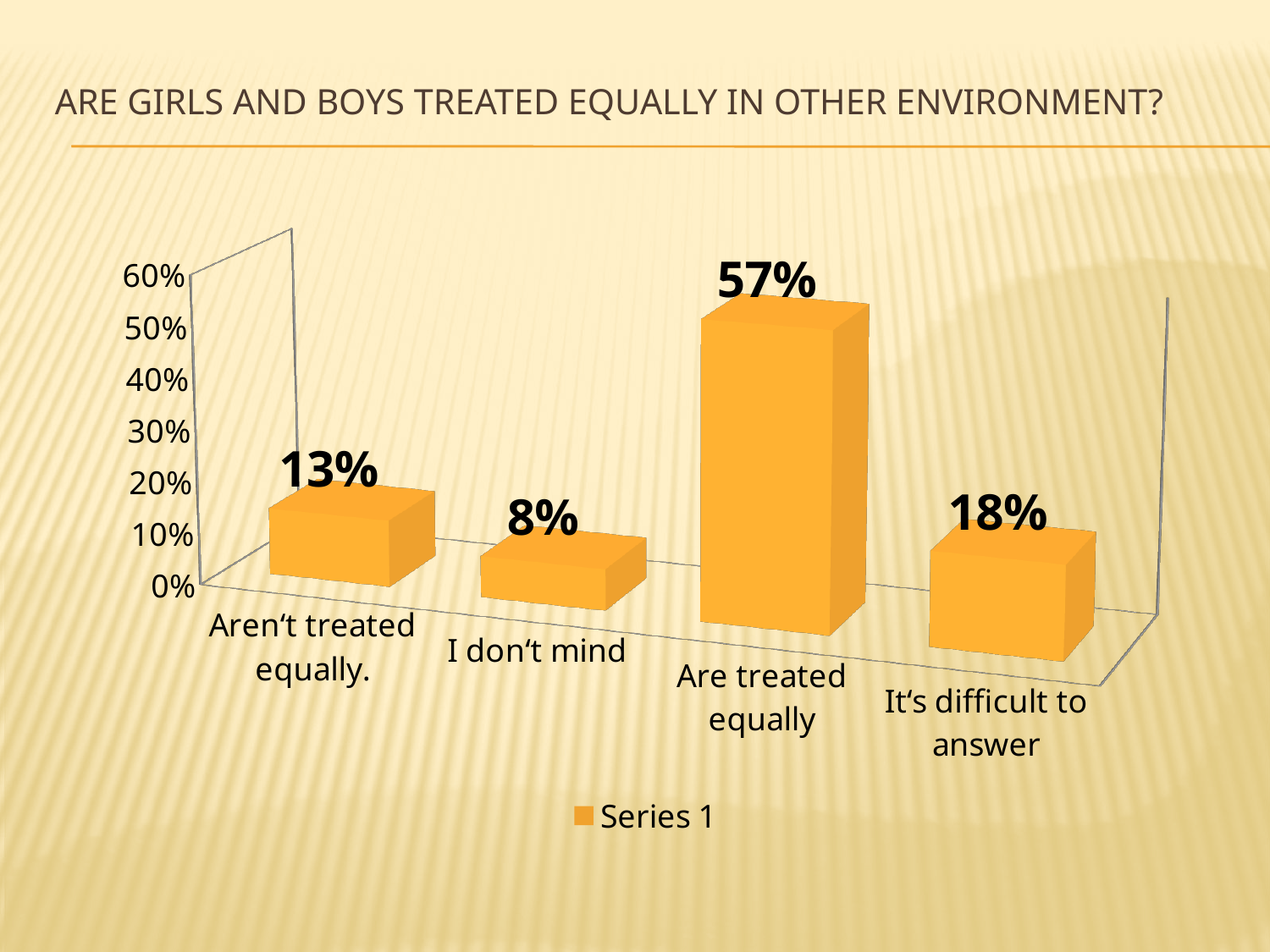
How many series does the legend list? 1 How many categories are shown on the x axis? 4 What is the difference between the values for "Are treated equally" and "It's difficult to answer"? 39% Which category has the lowest value? I don't mind What kind of chart is shown on the slide? bar chart Is the value for "Are treated equally" greater or less than 50%? greater What is the value for "Are treated equally"? 57% What is the value for "I don't mind"? 8% Which is larger, the value for "Aren't treated equally." or the value for "It's difficult to answer"? It's difficult to answer Which category has the highest value? Are treated equally What is the value for "It's difficult to answer"? 18% What is the value for "Aren't treated equally."? 13%